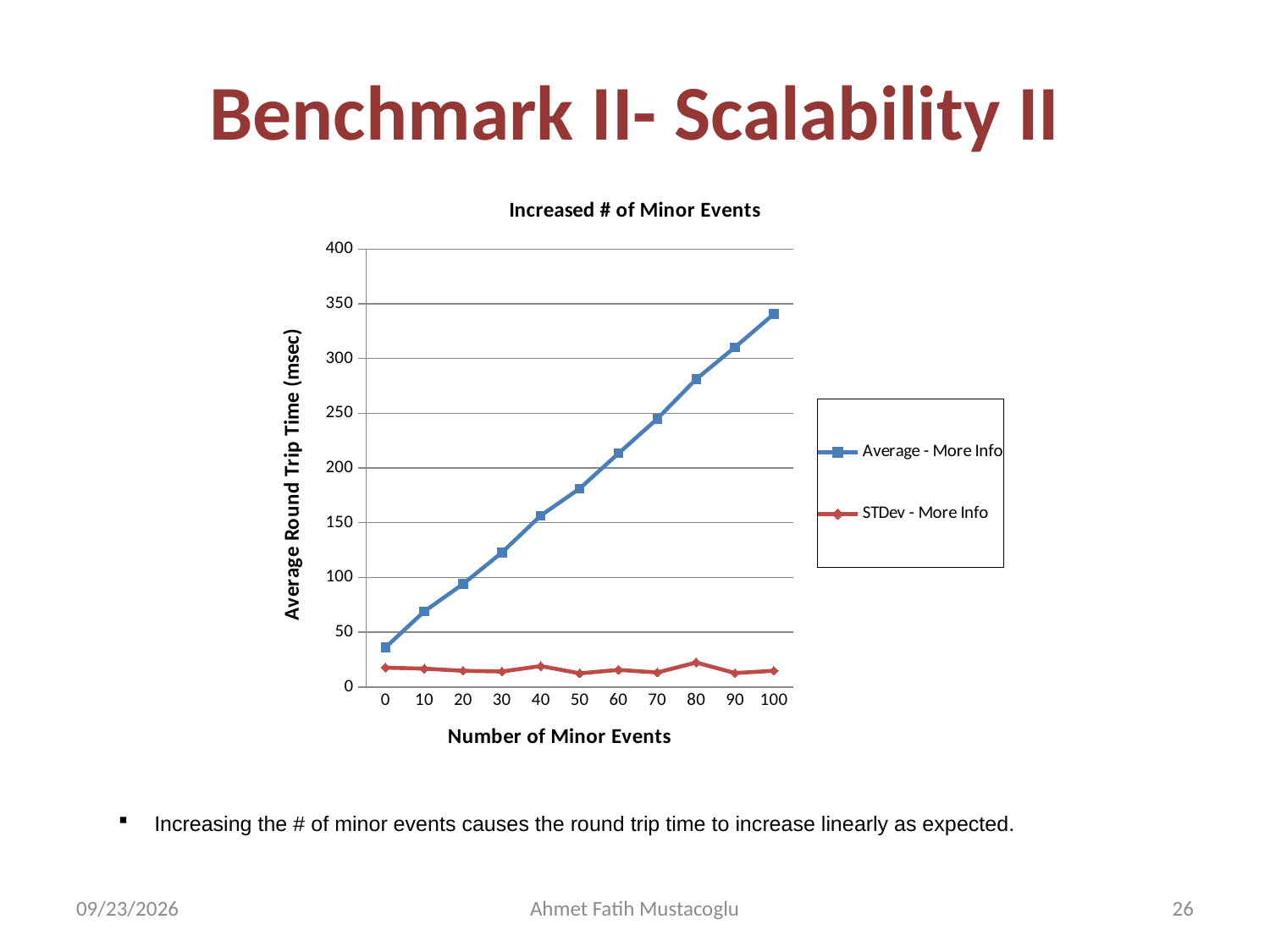
How many series does the legend list? 2 At which number of minor events is the Average - More Info series lowest? 0 Is the value of Average - More Info at 100 minor events greater or less than 300? greater At 50 minor events, which series has the larger value, Average - More Info or STDev - More Info? Average - More Info At which number of minor events is the Average - More Info series highest? 100 What kind of chart is shown on the slide? line chart Is the value of Average - More Info at 0 minor events greater or less than 50? less How many data points are plotted for the Average - More Info series? 11 Does the Average - More Info series rise or fall as the number of minor events increases? rise Is the value of STDev - More Info at 80 minor events greater or less than 50? less What is the label of the y axis? Average Round Trip Time (msec) What is the title of the chart? Increased # of Minor Events